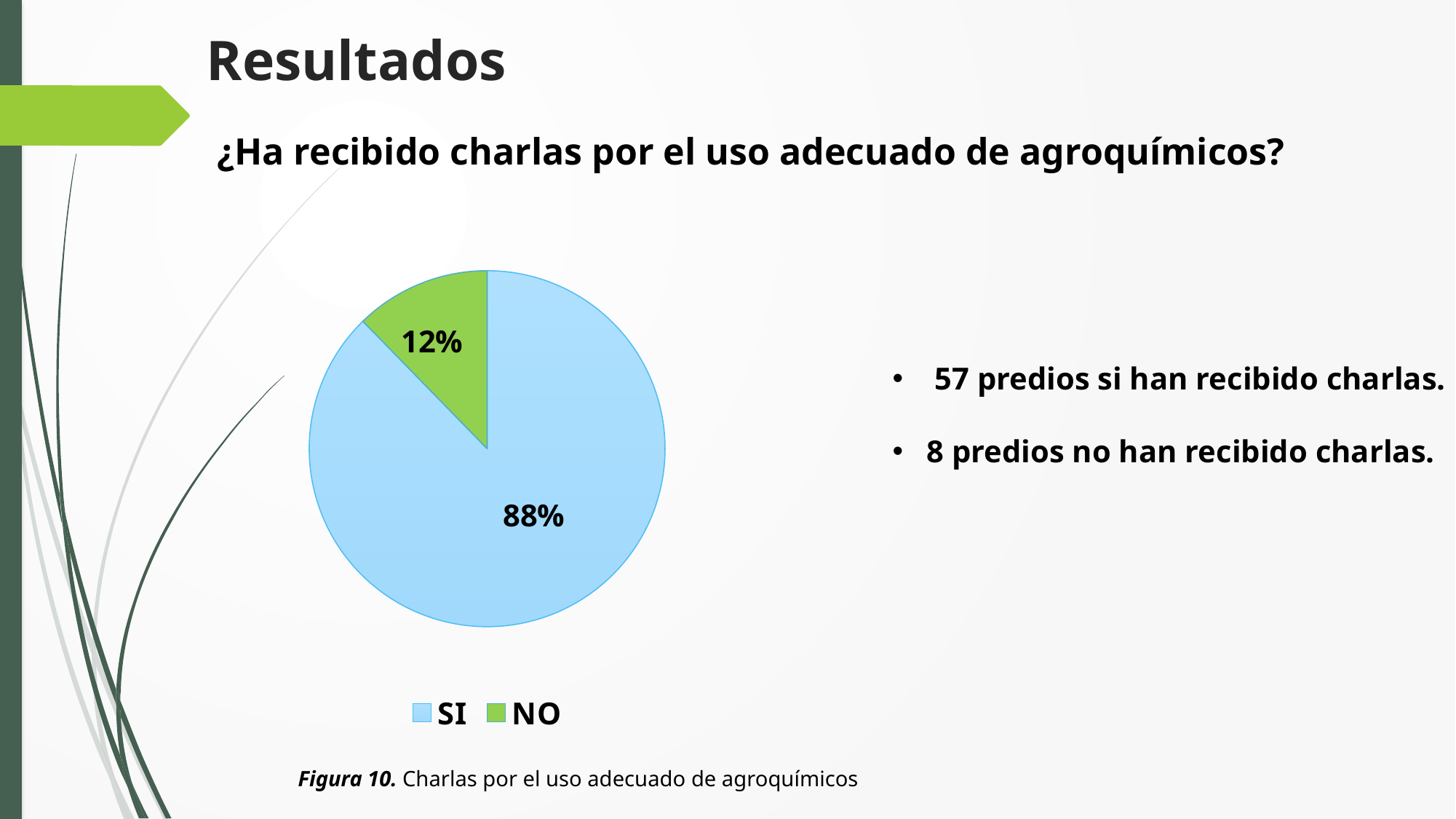
What percentage of the pie chart is labelled NO? 12% What is the figure caption below the pie chart? Figura 10. Charlas por el uso adecuado de agroquímicos What is the difference in percentage points between the SI slice and the NO slice? 76 How many entries does the legend list? 2 Which slice of the pie chart is the largest? SI What share of the pie does the NO slice represent? 12% What kind of chart is shown on the slide? pie chart What percentage of the pie chart is labelled SI? 88% Which slice of the pie chart is the smallest? NO What colour is the SI slice in the pie chart? light blue How many slices does the pie chart have? 2 Which slice is larger, SI or NO? SI